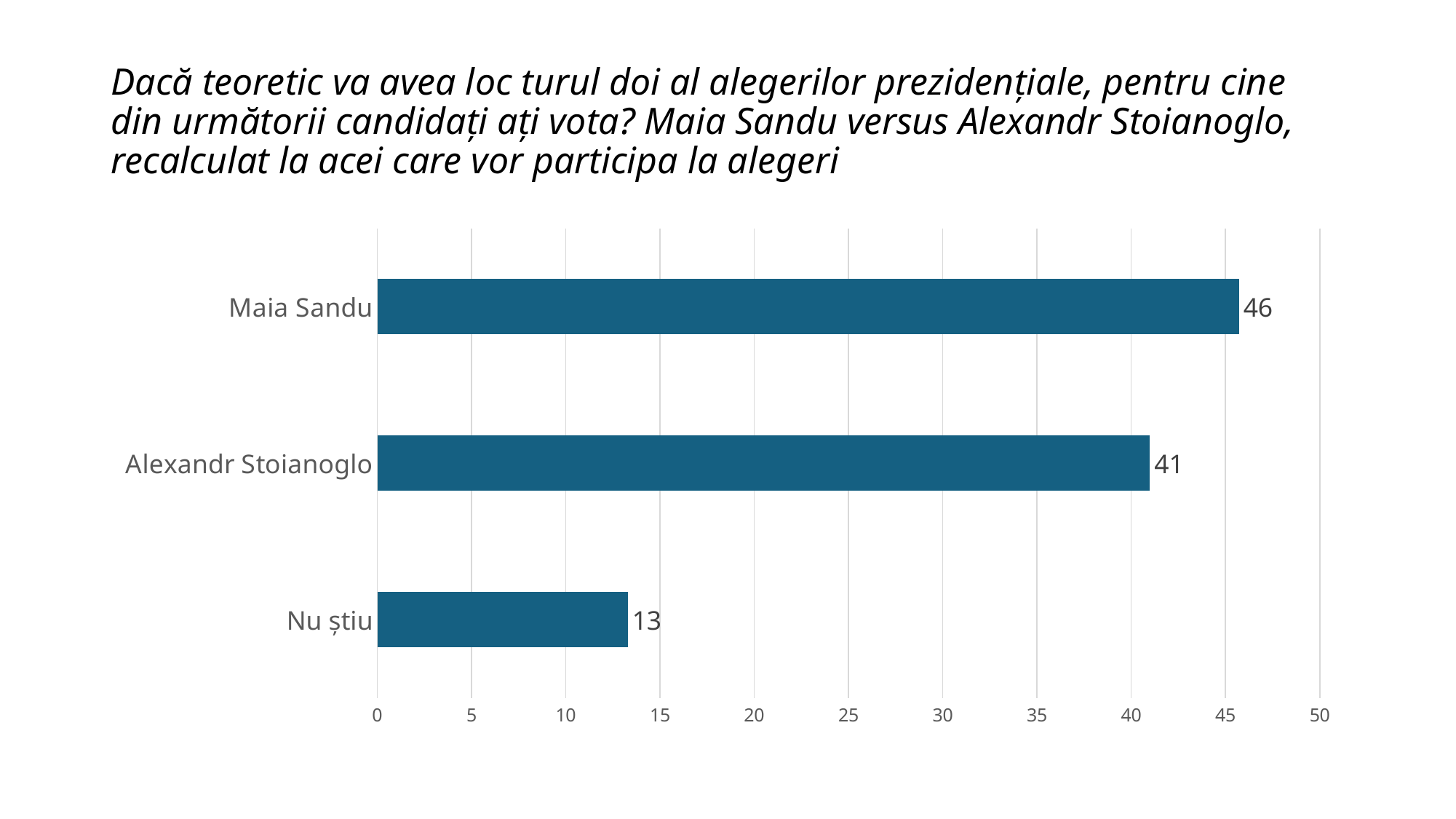
What is the difference between the values for Alexandr Stoianoglo and Nu știu? 28 What is the highest value shown on the x axis? 50 What kind of chart is shown on the slide? bar chart What is the value for Maia Sandu? 46 How many categories are shown in the chart? 3 Which is larger, the value for Maia Sandu or the value for Alexandr Stoianoglo? Maia Sandu Which category has the highest value? Maia Sandu What is the value for Alexandr Stoianoglo? 41 Is the value for Nu știu greater or less than 15? less Which category has the lowest value? Nu știu What is the value for Nu știu? 13 What is the difference between the values for Maia Sandu and Alexandr Stoianoglo? 5